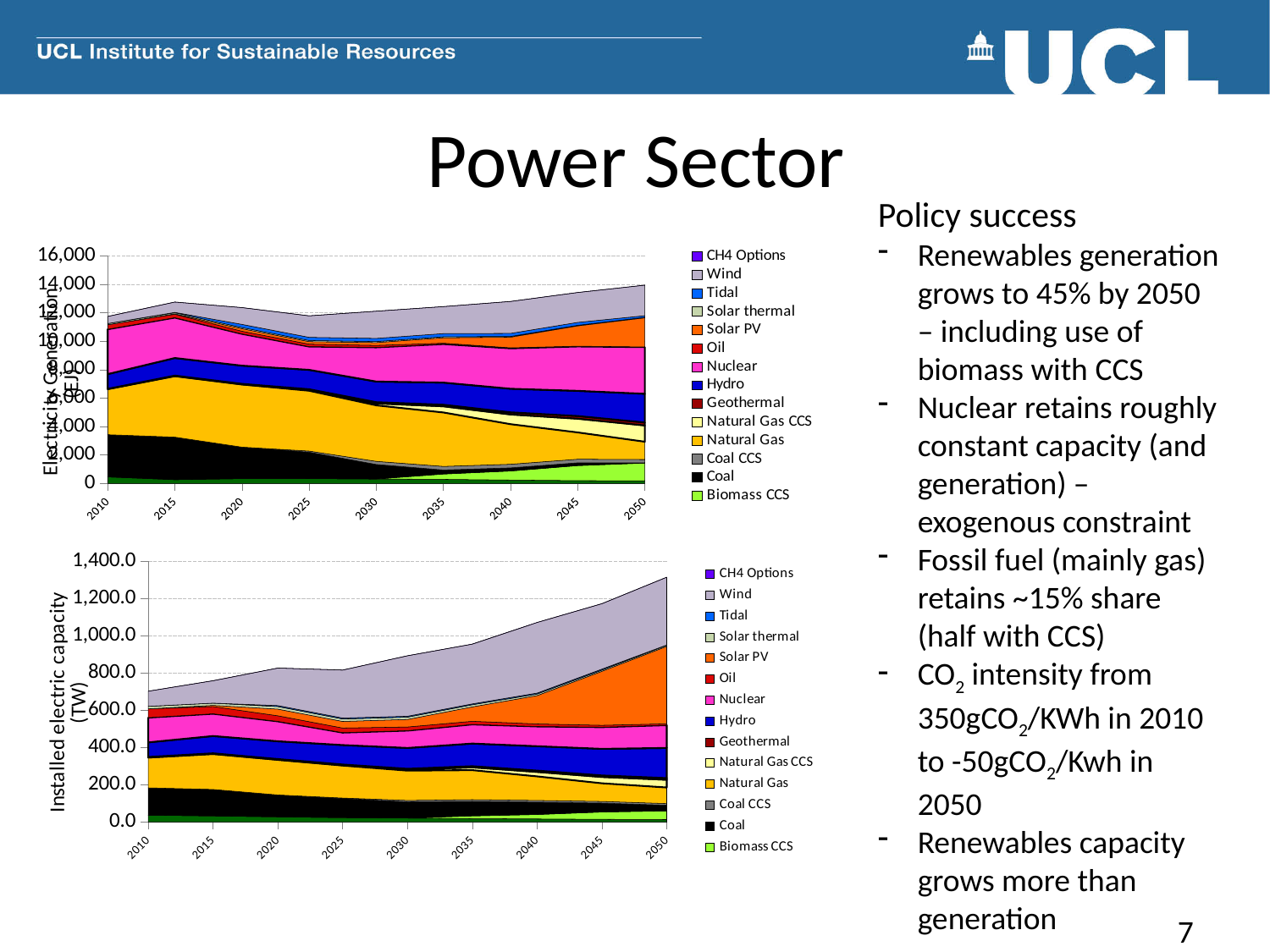
In the bottom chart (Installed electric capacity), does the total stacked value rise or fall between 2025 and 2050? rise What kind of chart is the top chart on the slide? Stacked area chart In the bottom chart (Installed electric capacity), is the total stacked value for 2010 greater or less than 800.0? less How many series does the legend of the top chart list? 14 What kind of chart is the bottom chart (Installed electric capacity)? Stacked area chart In the bottom chart, which year has the highest total installed electric capacity? 2050 In the top chart (Electricity Generation), is the total stacked value for 2050 greater or less than 12,000? greater Which legend entry in the top chart is shown in magenta/pink? Nuclear In the top chart (Electricity Generation), is the total stacked value for 2010 greater or less than 14,000? less What is the y-axis label of the bottom chart? Installed electric capacity (TW) How many years are shown along the x axis of the bottom chart (Installed electric capacity)? 9